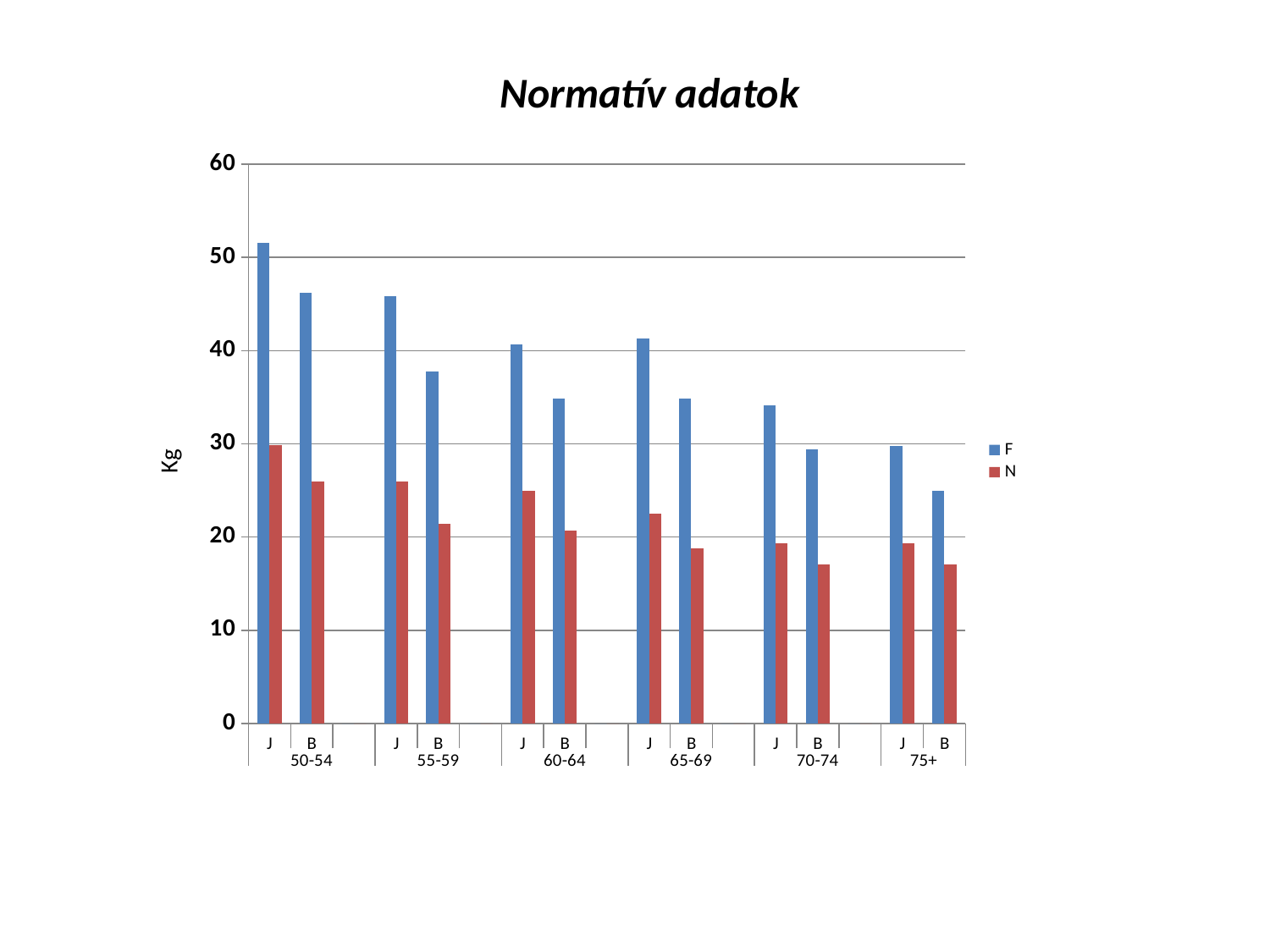
Which bar has the lowest F value? B in 75+ Which is larger, the F value for J in 55-59 or the F value for B in 55-59? J in 55-59 What is the title of the chart? Normatív adatok Is the F value for B in the 55-59 group greater or less than 40? less How many age groups are shown along the x axis? 6 Is the F value for J in the 50-54 group greater or less than 50? greater What kind of chart is shown on the slide? bar chart Do the F values for B generally rise or fall as the age group increases from 50-54 to 75+? fall How many series does the legend list? 2 Which bar has the highest F value? J in 50-54 Which is larger, the N value for J in 50-54 or the N value for J in 75+? J in 50-54 What is the label on the vertical axis? Kg